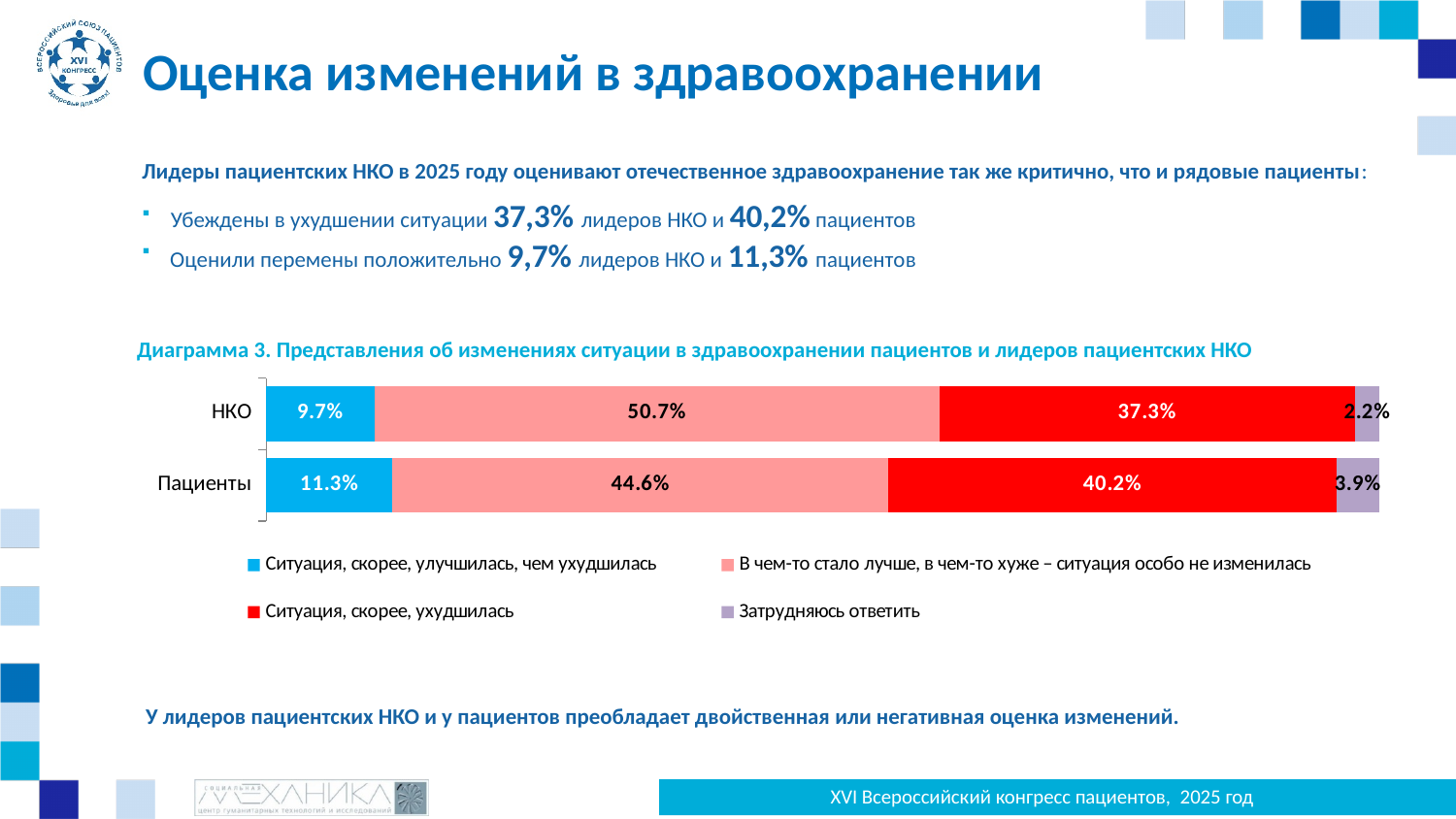
Which segment is the smallest in the Пациенты bar? Затрудняюсь ответить How many series does the legend list? 4 What is the value for 'Ситуация, скорее, улучшилась, чем ухудшилась' in the Пациенты bar? 11.3% Which segment is the largest in the НКО bar? В чем-то стало лучше, в чем-то хуже – ситуация особо не изменилась How many categories are plotted on the chart? 2 What is the value for 'В чем-то стало лучше, в чем-то хуже – ситуация особо не изменилась' in the НКО bar? 50.7% What is the value for 'Затрудняюсь ответить' in the Пациенты bar? 3.9% What is the value for 'Ситуация, скорее, ухудшилась' in the НКО bar? 37.3% What is the difference between the 'В чем-то стало лучше, в чем-то хуже – ситуация особо не изменилась' values for НКО and Пациенты? 6.1% What colour represents 'Ситуация, скорее, ухудшилась' in the chart? Red What kind of chart is shown on the slide? Stacked bar chart Which category has the higher value for 'Ситуация, скорее, ухудшилась': НКО or Пациенты? Пациенты